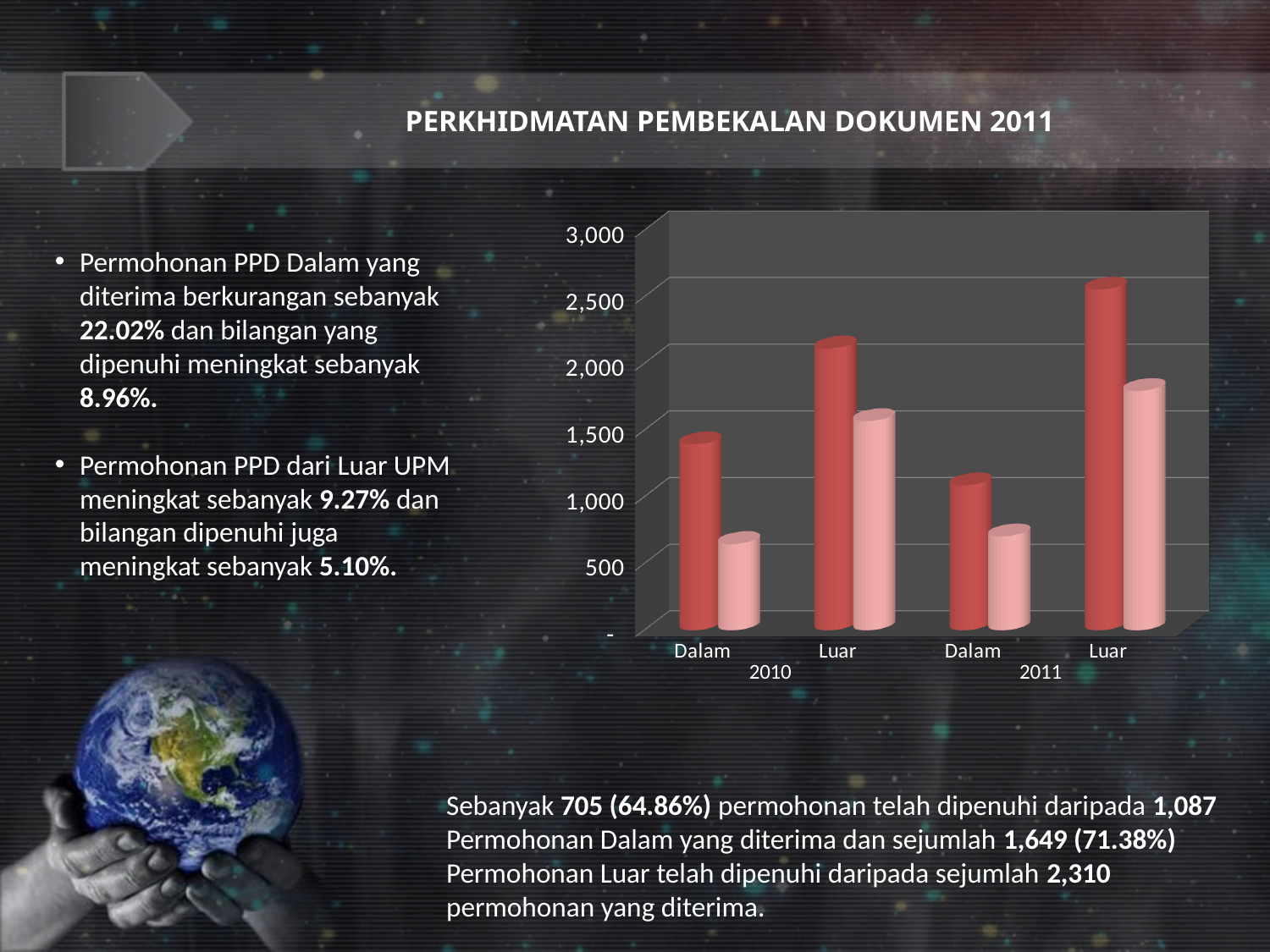
Which category has the tallest bar in the chart? Luar 2011 How many category groups are shown along the x axis of the chart? 4 Is the dark red bar for Dalam 2010 greater or less than 1,500? less Is the light pink bar for Dalam 2011 greater or less than 500? greater Among the dark red bars, which category has the lowest value? Dalam 2011 What kind of chart is shown on the slide? bar chart What is the highest value shown on the chart's vertical axis? 3,000 Is the light pink bar for Luar 2011 greater or less than 1,500? greater Which dark red bar is taller: Luar 2010 or Dalam 2011? Luar 2010